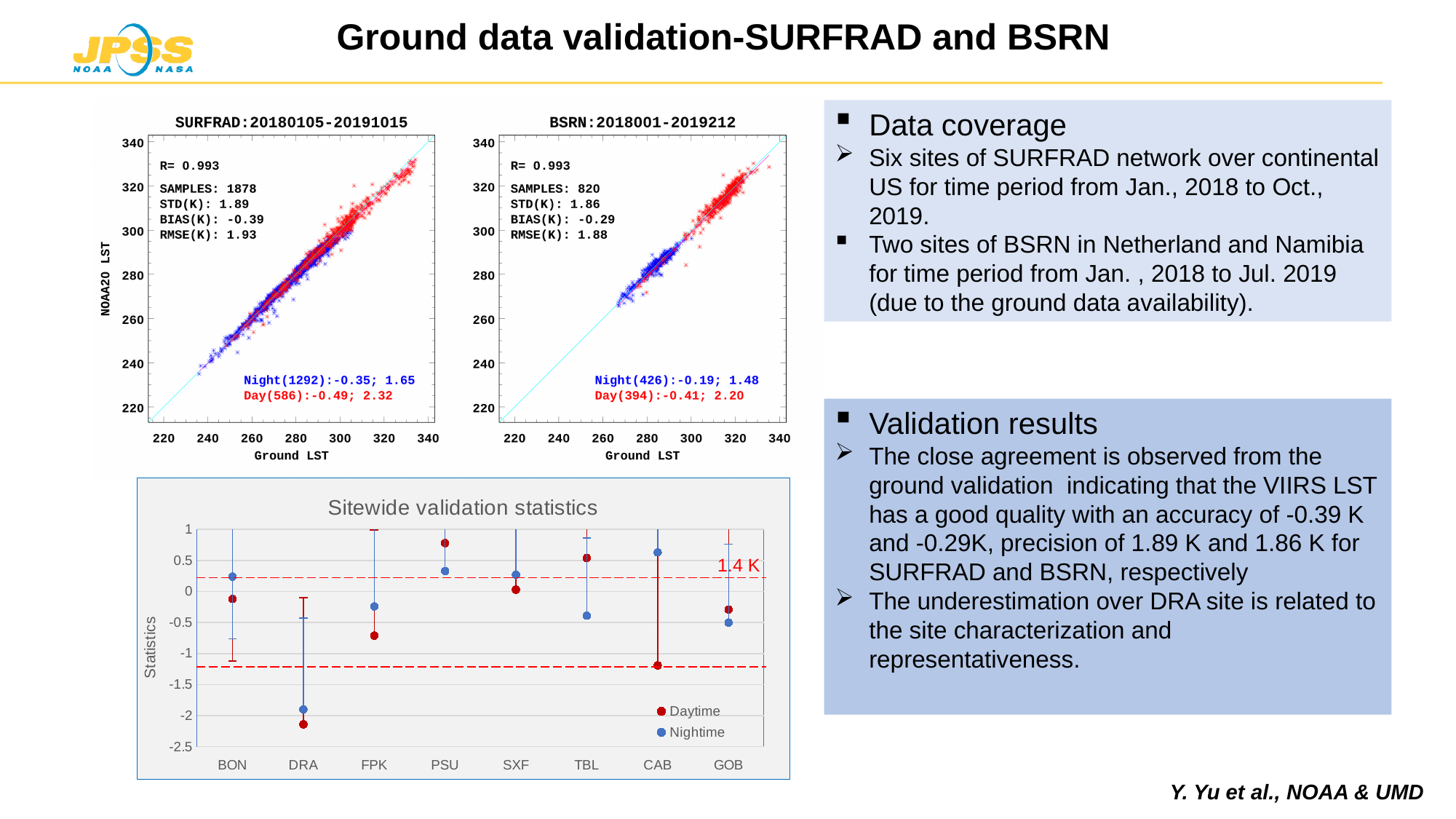
In the BSRN scatter plot, how many night samples are listed? 426 In the Sitewide validation statistics chart, which site has the lowest Daytime value? DRA In the SURFRAD scatter plot, what is the number of samples? 1878 What is the difference between the SURFRAD and BSRN sample counts shown in the two scatter plots? 1058 In the SURFRAD scatter plot, what is the BIAS(K) value? -0.39 In the Sitewide validation statistics chart, how many series does the legend list? 2 In the Sitewide validation statistics chart, is the Daytime value for PSU greater or less than 0.5? greater In the BSRN scatter plot, what is the RMSE(K) value? 1.88 Which scatter plot has the larger STD(K), SURFRAD or BSRN? SURFRAD What is the title of the chart at the bottom left of the slide? Sitewide validation statistics In the Sitewide validation statistics chart, is the Daytime value for CAB greater or less than -1? less In the Sitewide validation statistics chart, how many sites are shown on the x axis? 8